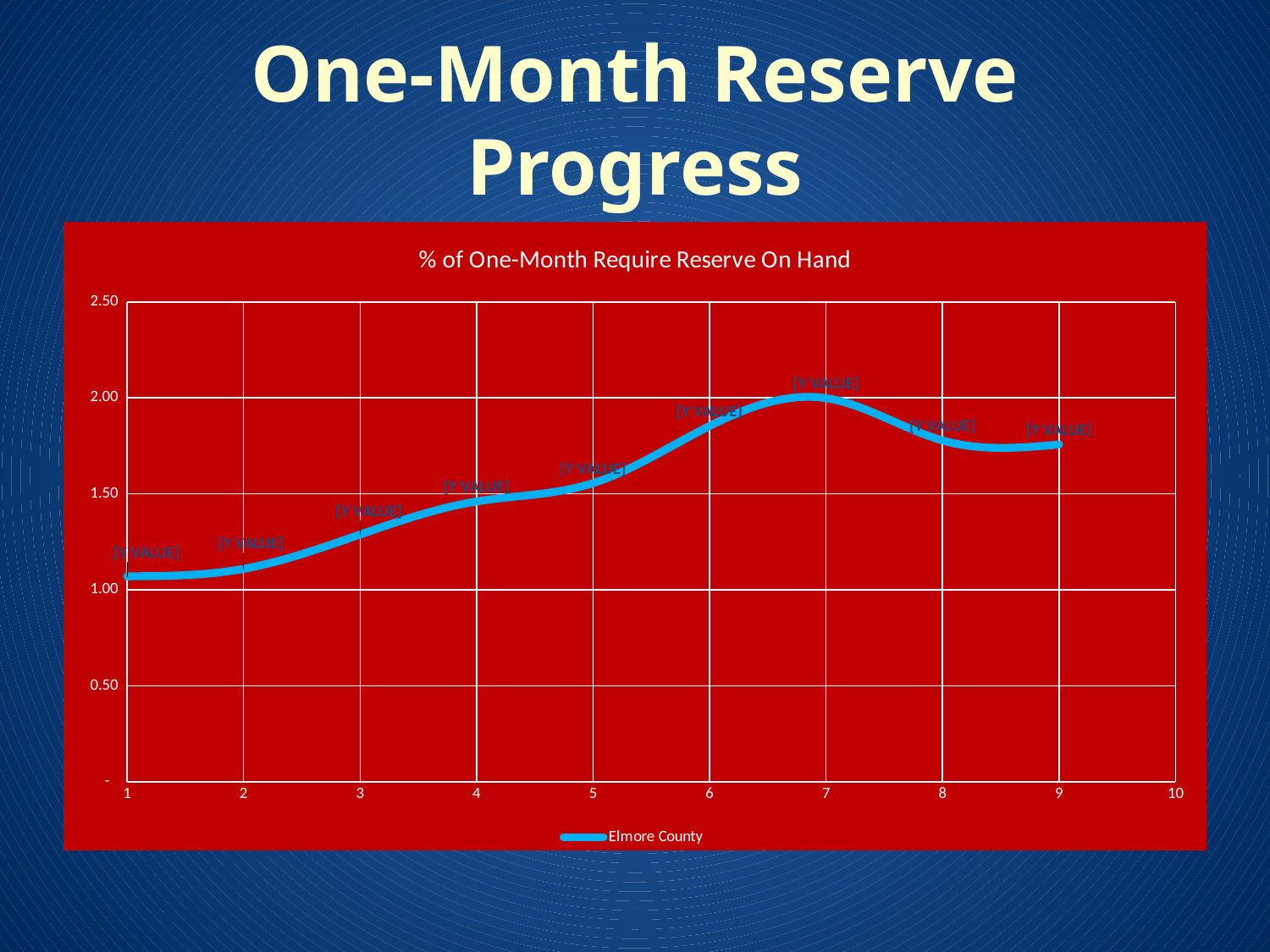
Is the value at point 8 greater or less than 1.50? greater How many series does the legend list? 1 What is the title of the chart? % of One-Month Require Reserve On Hand Is the value at point 3 greater or less than 1.50? less Is the value at point 1 greater or less than 1.50? less Does the line rise or fall from point 1 to point 7? rise Which has the larger value, point 3 or point 6? point 6 At which x-axis point does the line reach its highest value? 7 How many data points are plotted on the line? 9 What kind of chart is shown on the slide? line chart What series name does the legend show? Elmore County